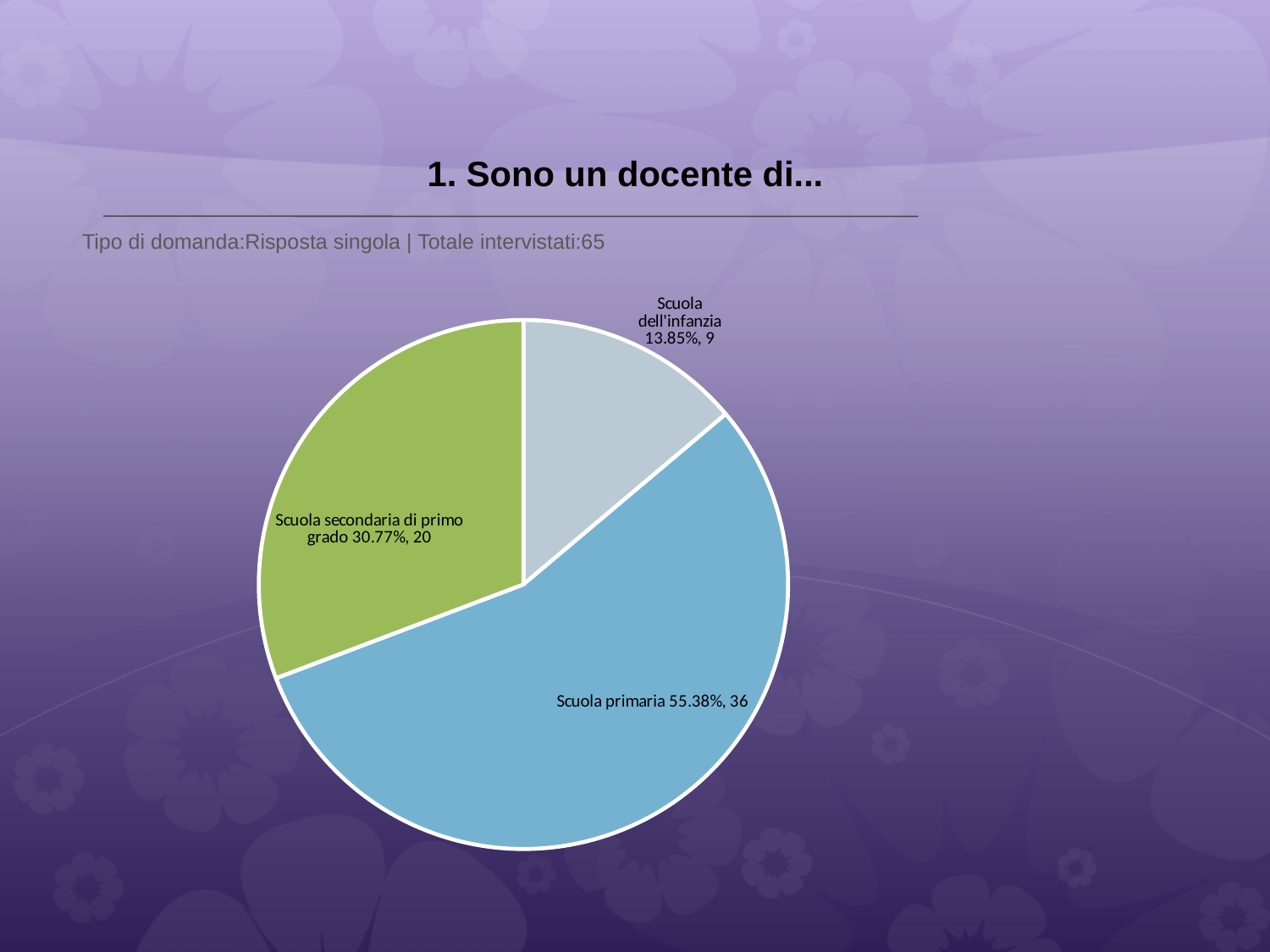
How many respondents are in the Scuola secondaria di primo grado slice? 20 How many slices does the pie chart have? 3 Which has more respondents, Scuola secondaria di primo grado or Scuola dell'infanzia? Scuola secondaria di primo grado What percentage share does Scuola dell'infanzia have? 13.85% What is the difference in respondent count between Scuola primaria and Scuola secondaria di primo grado? 16 What is the title of the chart? 1. Sono un docente di... How many respondents are in the Scuola dell'infanzia slice? 9 Which category has the smallest slice? Scuola dell'infanzia What kind of chart is shown on the slide? pie chart What percentage share does Scuola primaria have? 55.38% Which category has the largest slice? Scuola primaria What is the total number of respondents across all slices? 65